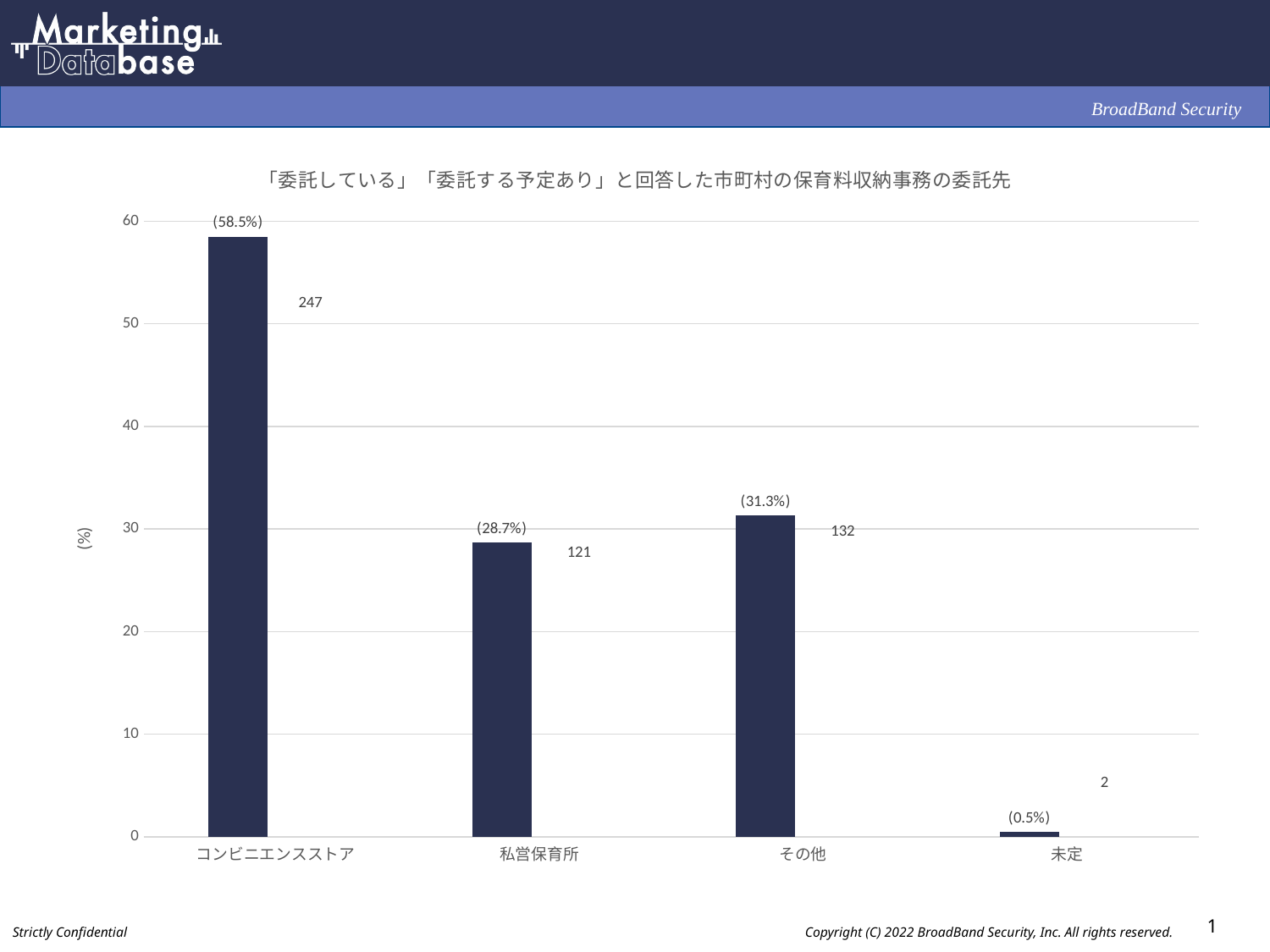
What count is shown next to the bar for 私営保育所? 121 Which category has the lowest value? 未定 What kind of chart is shown on the slide? bar chart Which category has the highest value? コンビニエンスストア Is the value for 私営保育所 greater or less than 30? less What count is shown for 未定? 2 What percentage is shown for その他? 31.3% What unit is shown on the y axis label? (%) What is the difference in percentage points between コンビニエンスストア and その他? 27.2 What percentage is shown for コンビニエンスストア? 58.5% How many categories are shown on the x axis? 4 Which is larger, the value for 私営保育所 or the value for その他? その他